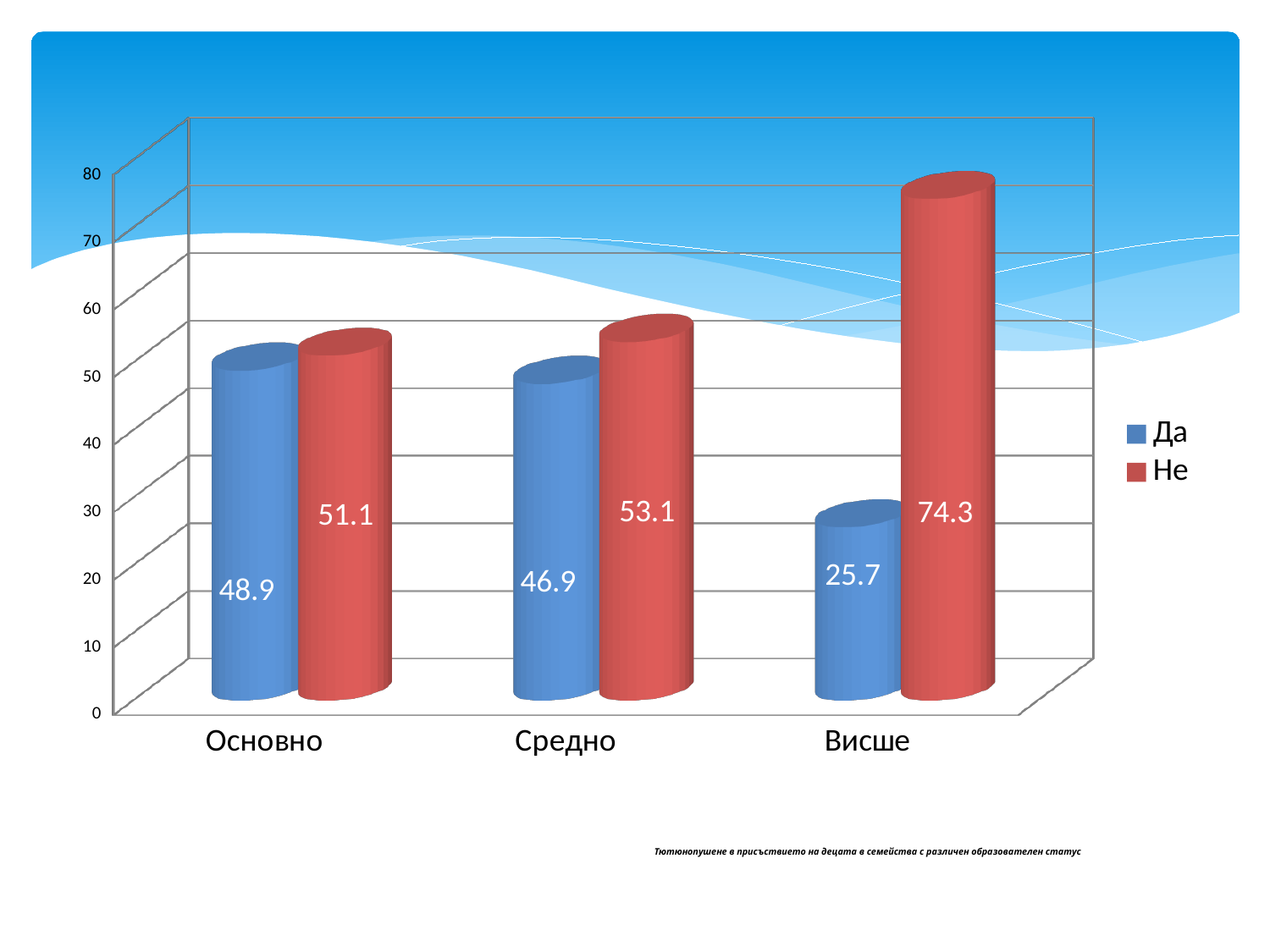
What is the value for "Да" in the "Основно" category? 48.9 What is the difference between the "Не" and "Да" values in the "Висше" category? 48.6 How many categories are shown on the x axis? 3 How many series does the legend list? 2 Which category has the highest value for "Не"? Висше What is the value for "Не" in the "Средно" category? 53.1 What kind of chart is shown on the slide? bar chart What is the difference between the "Не" and "Да" values in the "Средно" category? 6.2 Is the value for "Не" in "Висше" greater or less than 70? greater What is the value for "Не" in the "Висше" category? 74.3 Which is larger in the "Основно" category, "Да" or "Не"? Не Which category has the lowest value for "Да"? Висше